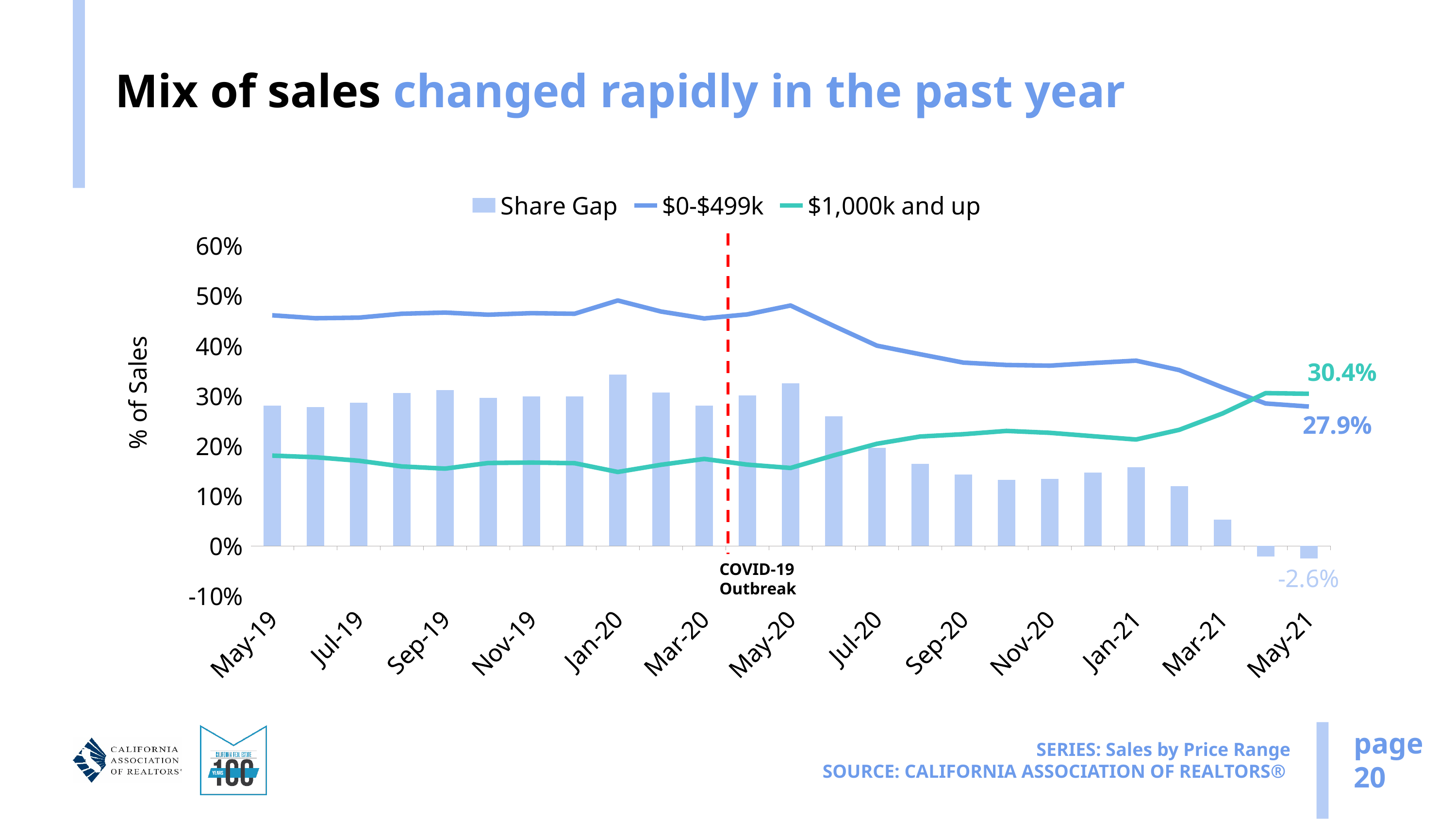
What kind of chart is shown on the slide? Combination bar and line chart What is the value of the $0-$499k series in May-21? 27.9% Do the Share Gap bars rise or fall from Jul-20 to May-21? fall How many series does the legend list? 3 What is the value of the $1,000k and up series in May-21? 30.4% What is the Share Gap value in May-21? -2.6% In May-21, which series has the larger value: $0-$499k or $1,000k and up? $1,000k and up Is the value of the $0-$499k series in May-19 greater or less than 40%? greater In which month is the Share Gap bar the highest? Jan-20 What event does the red dashed vertical line mark? COVID-19 Outbreak In May-21, how much higher is the $1,000k and up share than the $0-$499k share? 2.5 percentage points Is the value of the $1,000k and up series in May-19 greater or less than 30%? less